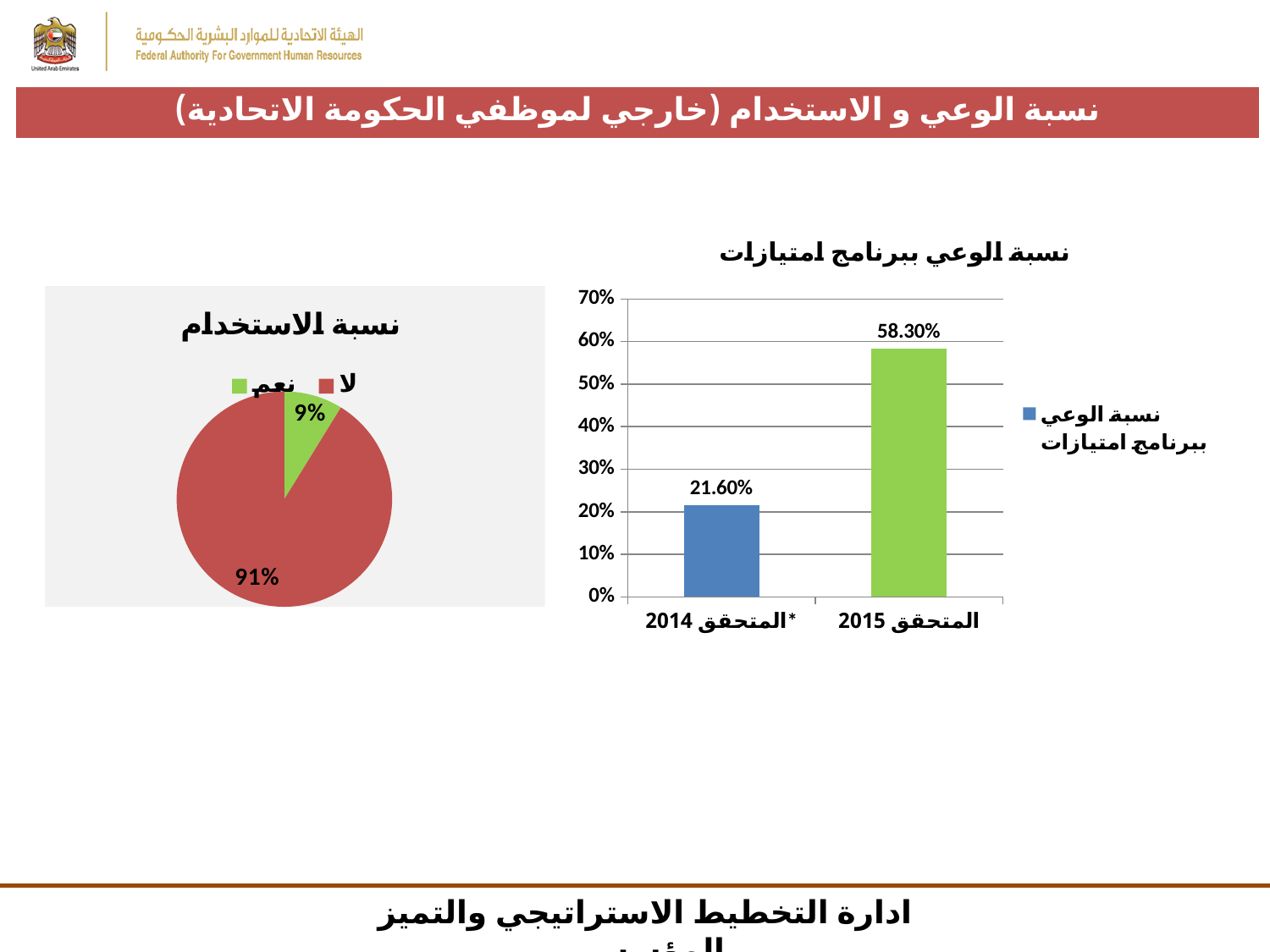
In the bar chart titled "نسبة الوعي ببرنامج امتيازات", how many categories are shown on the x axis? 2 What kind of chart is the one titled "نسبة الاستخدام"? pie chart In the pie chart titled "نسبة الاستخدام", which slice is larger, "نعم" or "لا"? لا What kind of chart is the one titled "نسبة الوعي ببرنامج امتيازات"? bar chart In the bar chart titled "نسبة الوعي ببرنامج امتيازات", what is the value for "المتحقق 2015"? 58.30% In the bar chart titled "نسبة الوعي ببرنامج امتيازات", what is the difference between the values for "المتحقق 2015" and "المتحقق 2014*"? 36.70% In the bar chart titled "نسبة الوعي ببرنامج امتيازات", which category has the lowest value? المتحقق 2014* In the bar chart titled "نسبة الوعي ببرنامج امتيازات", what is the value for "المتحقق 2014*"? 21.60% In the bar chart titled "نسبة الوعي ببرنامج امتيازات", do the values rise or fall from "المتحقق 2014*" to "المتحقق 2015"? rise In the bar chart titled "نسبة الوعي ببرنامج امتيازات", which category has the highest value? المتحقق 2015 In the pie chart titled "نسبة الاستخدام", what share does the "نعم" slice have? 9% In the pie chart titled "نسبة الاستخدام", what share does the "لا" slice have? 91%